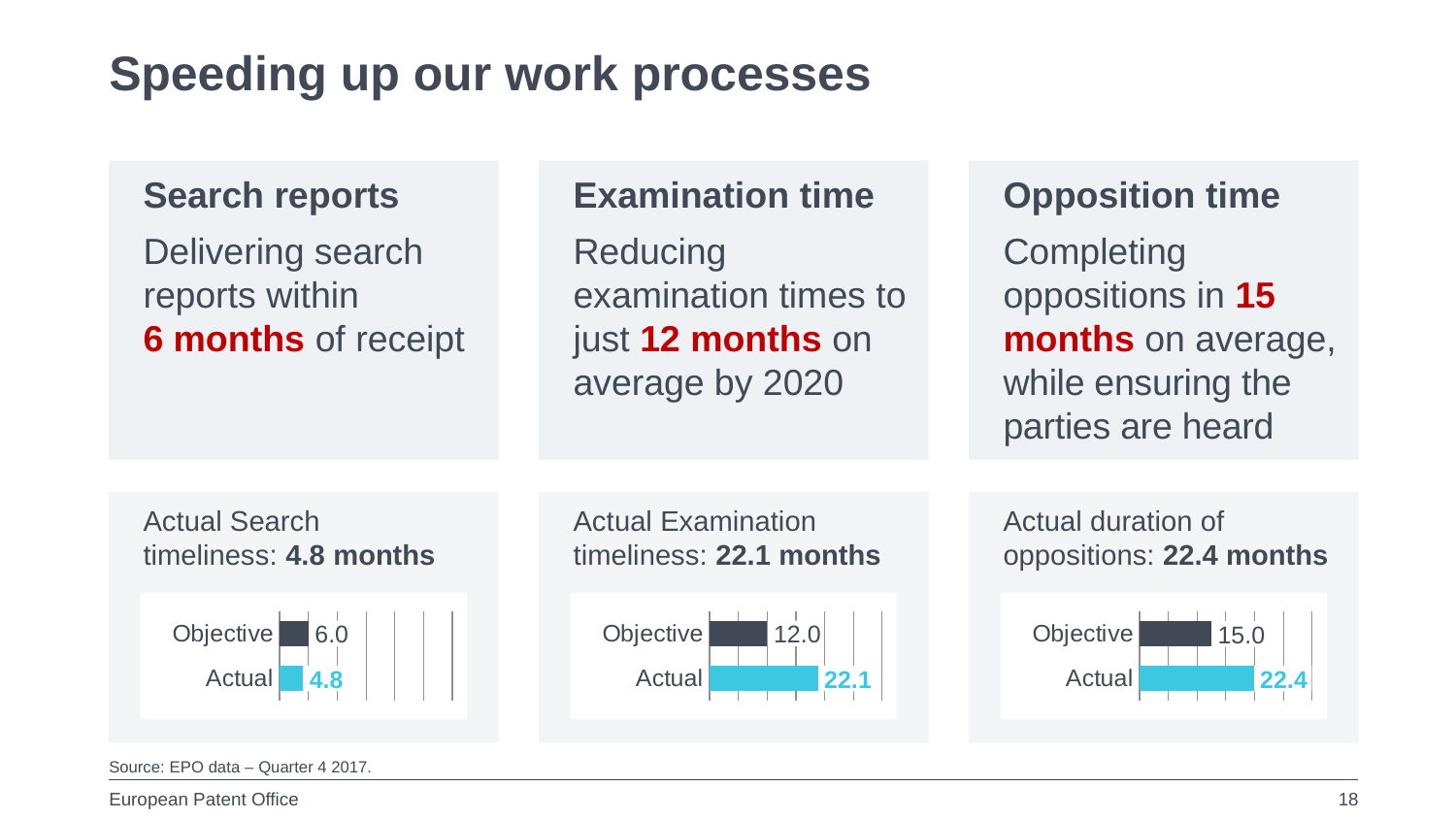
In the left chart (Search reports), what is the difference between the Objective and Actual values? 1.2 In the right chart (Opposition time), what is the value for Actual? 22.4 In the middle chart (Examination time), which bar is longer, Objective or Actual? Actual In the right chart (Opposition time), what is the difference between the Actual and Objective values? 7.4 In the right chart (Opposition time), what is the value for Objective? 15.0 What type of chart is used in the middle chart (Examination time)? Bar chart In the left chart (Search reports), which bar is shorter, Objective or Actual? Actual In the left chart (Search reports), what is the value for Objective? 6.0 In the middle chart (Examination time), what is the value for Actual? 22.1 In the middle chart (Examination time), what is the difference between the Actual and Objective values? 10.1 In the left chart (Search reports), what is the value for Actual? 4.8 How many bars does the right chart (Opposition time) show? 2